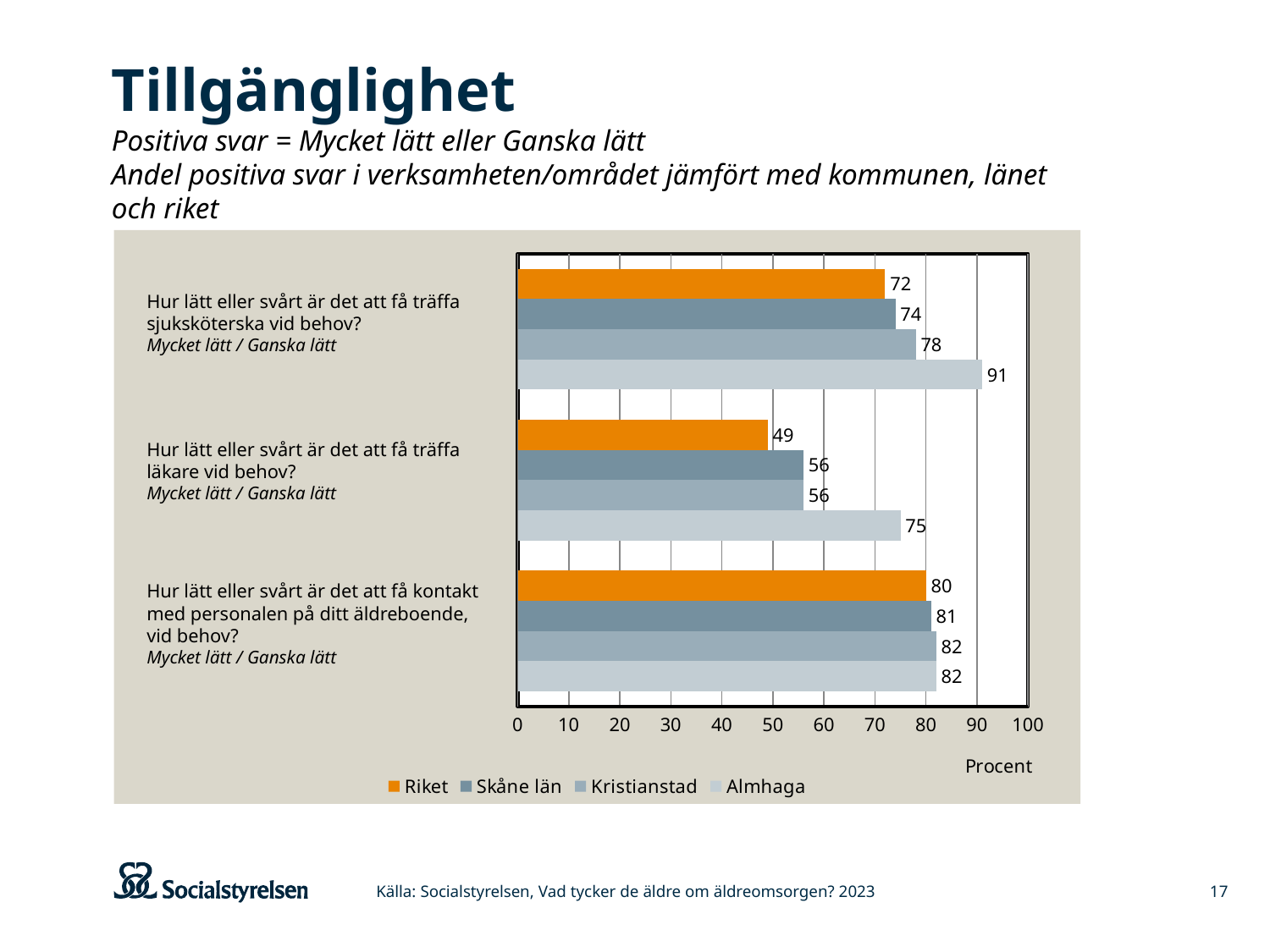
Which series has the lowest value on the question about meeting a nurse when needed? Riket What type of chart is shown on the slide? Bar chart Which is larger: Almhaga's value for meeting a doctor or Riket's value for contacting staff at the care home? Riket's value for contacting staff (80) How many questions (categories) are shown on the chart? 3 What is the difference between Almhaga and Riket on the question about meeting a nurse when needed? 19 What is the difference between Almhaga and Kristianstad on the question about meeting a doctor when needed? 19 What value is shown for Riket on the question about meeting a doctor when needed (träffa läkare vid behov)? 49 Which series has the highest value on the question about meeting a doctor when needed? Almhaga How many series does the legend list? 4 What value is shown for Skåne län on the question about meeting a nurse when needed? 74 What value is shown for Almhaga on the question about meeting a nurse when needed (träffa sjuksköterska vid behov)? 91 What value is shown for Kristianstad on the question about getting in contact with staff at the care home (kontakt med personalen)? 82